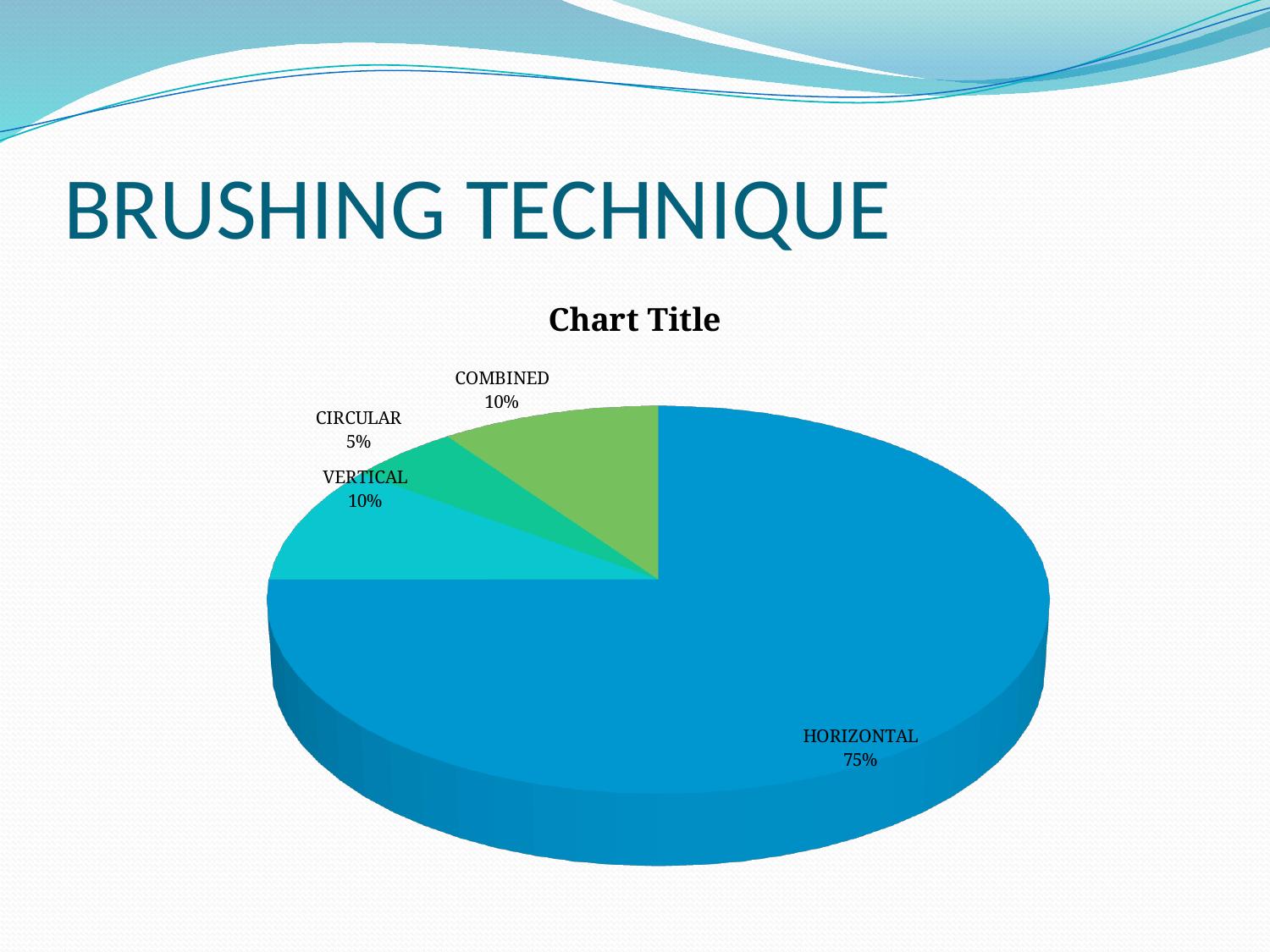
What is the difference in percentage points between HORIZONTAL and VERTICAL? 65 How many slices does the pie chart have? 4 What percentage of the pie is VERTICAL? 10% What colour is the HORIZONTAL slice? blue What is the title shown above the pie chart? Chart Title What percentage of the pie is CIRCULAR? 5% What percentage of the pie is COMBINED? 10% Which brushing technique has the largest share of the pie? HORIZONTAL What kind of chart is shown on the slide? pie chart What percentage of the pie is HORIZONTAL? 75% Which brushing technique has the smallest share of the pie? CIRCULAR Which is larger, the share for COMBINED or the share for CIRCULAR? COMBINED